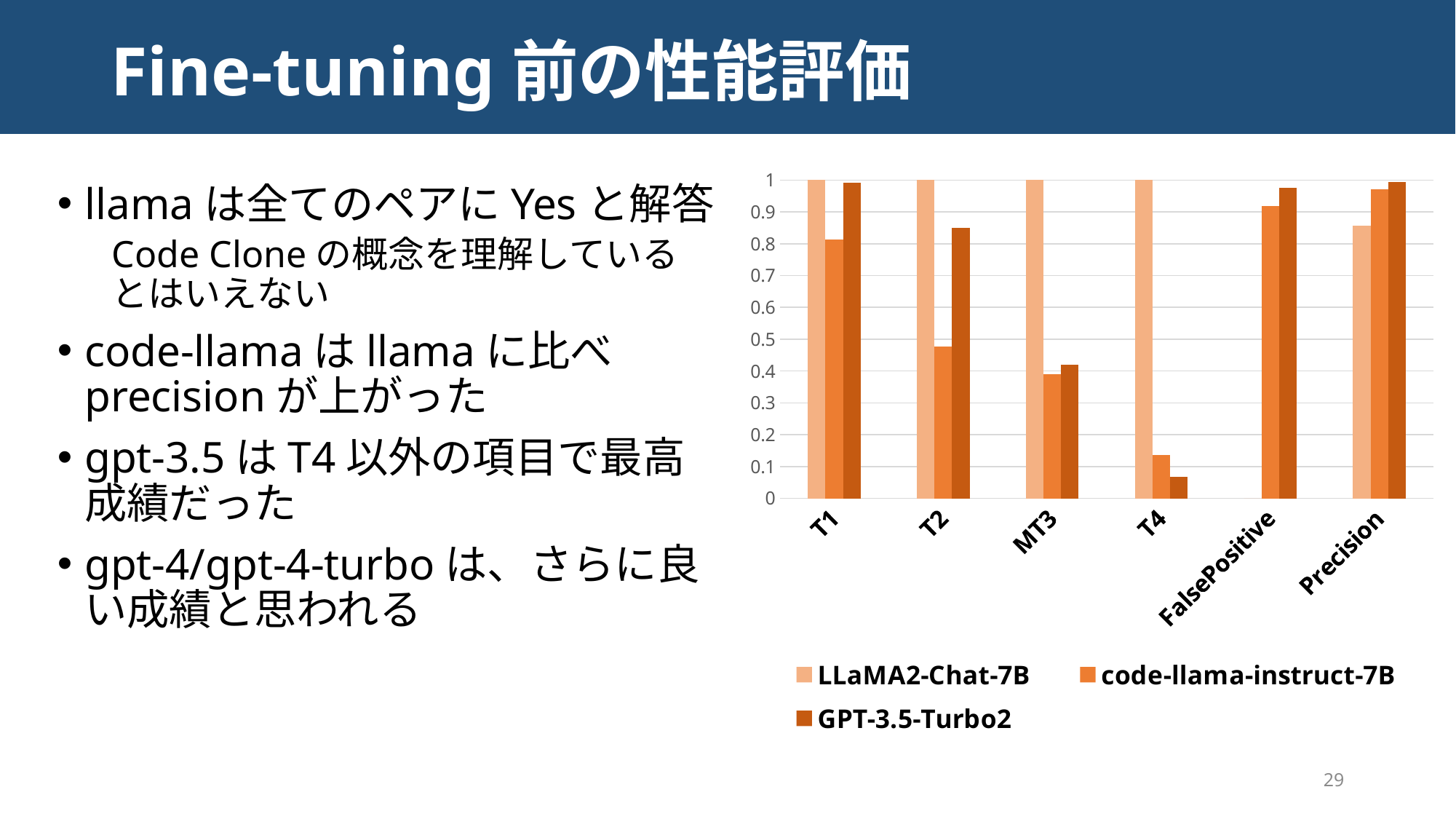
Is the value for GPT-3.5-Turbo2 at T2 greater or less than 0.8? greater Is the value for code-llama-instruct-7B at T4 greater or less than 0.2? less What is the value for LLaMA2-Chat-7B at T1? 1 What kind of chart is shown on the slide? bar chart Is the value for code-llama-instruct-7B at T2 greater or less than 0.5? less How many categories are shown on the x axis of the chart? 6 Which series has the highest value at T4? LLaMA2-Chat-7B At T2, which is larger: the value for code-llama-instruct-7B or the value for GPT-3.5-Turbo2? GPT-3.5-Turbo2 Which series has the lowest value at T4? GPT-3.5-Turbo2 What is the value for LLaMA2-Chat-7B at T4? 1 How many series does the chart legend list? 3